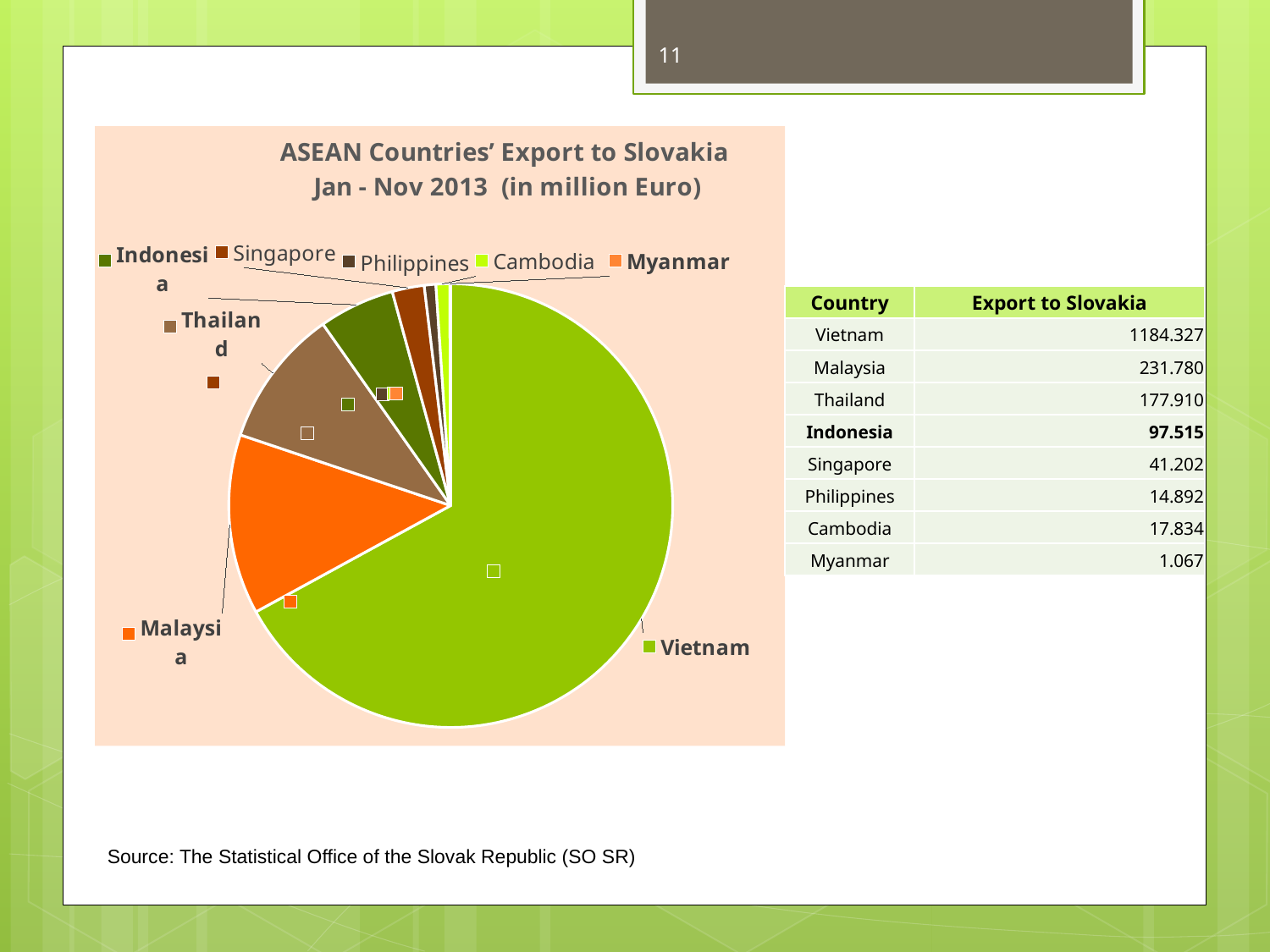
What kind of chart is shown on the slide? Pie chart Which is larger, the export to Slovakia from Cambodia or from the Philippines? Cambodia How many countries are shown in the pie chart? 8 What is the value of Singapore's export to Slovakia? 41.202 Which is larger, the export to Slovakia from Malaysia or from Thailand? Malaysia What is the value of Vietnam's export to Slovakia? 1184.327 Which country has the largest export to Slovakia? Vietnam What is the value of Indonesia's export to Slovakia? 97.515 What is the difference between Cambodia's and the Philippines' export to Slovakia? 2.942 Which country has the smallest export to Slovakia? Myanmar What is the difference between Malaysia's and Thailand's export to Slovakia? 53.870 What is the title of the chart? ASEAN Countries' Export to Slovakia Jan - Nov 2013 (in million Euro)